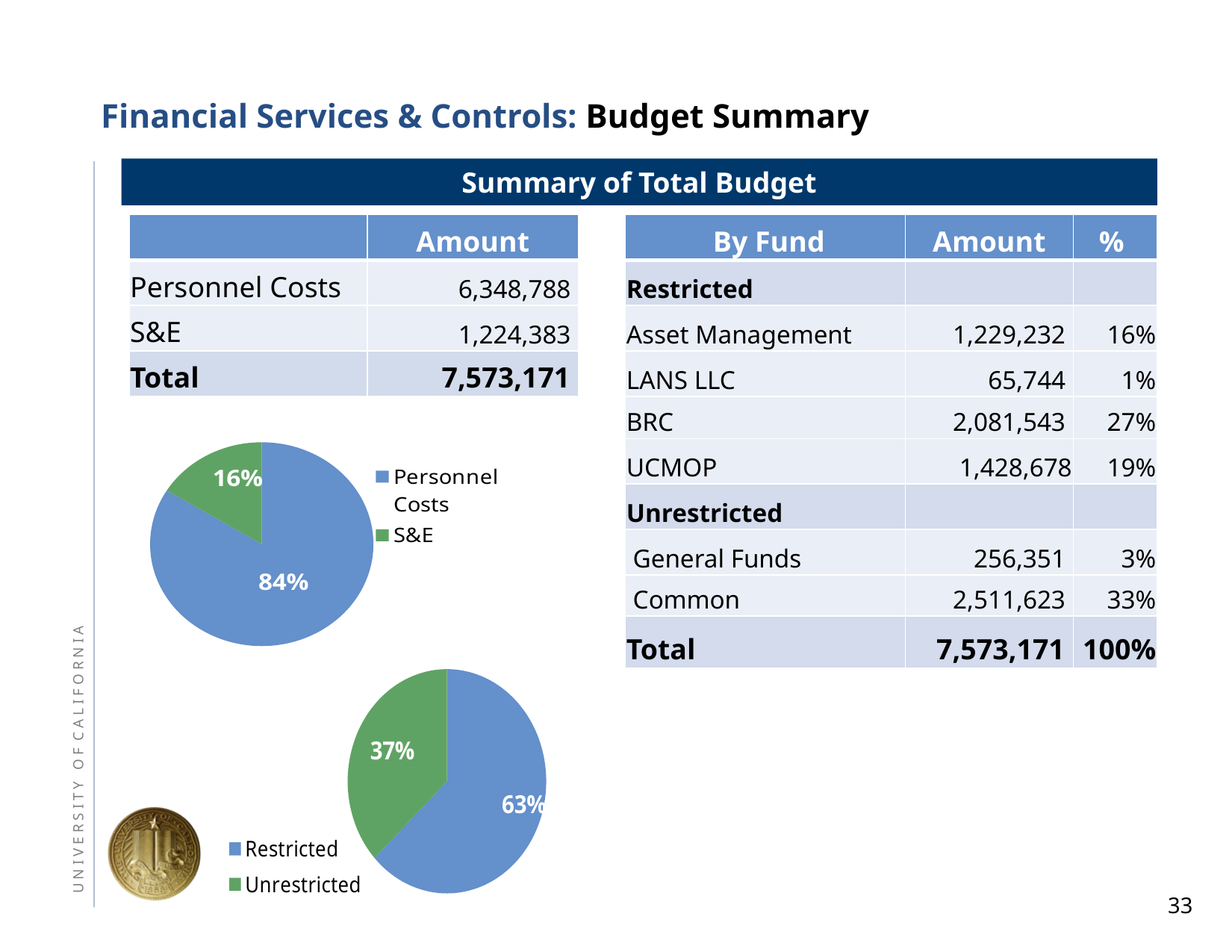
In the lower pie chart, what colour is the Unrestricted slice? green What kind of chart is the upper chart on the left of the slide? pie chart In the upper pie chart, which slice is the largest? Personnel Costs In the upper pie chart, what is the difference in percentage points between Personnel Costs and S&E? 68 In the lower pie chart, what is the difference in percentage points between Restricted and Unrestricted? 26 In the lower pie chart, which slice is the smallest? Unrestricted How many slices does the upper pie chart have? 2 In the upper pie chart, what share does Personnel Costs have? 84% In the lower pie chart, which is larger, Restricted or Unrestricted? Restricted In the lower pie chart, what share does Unrestricted have? 37% In the lower pie chart, what share does Restricted have? 63%